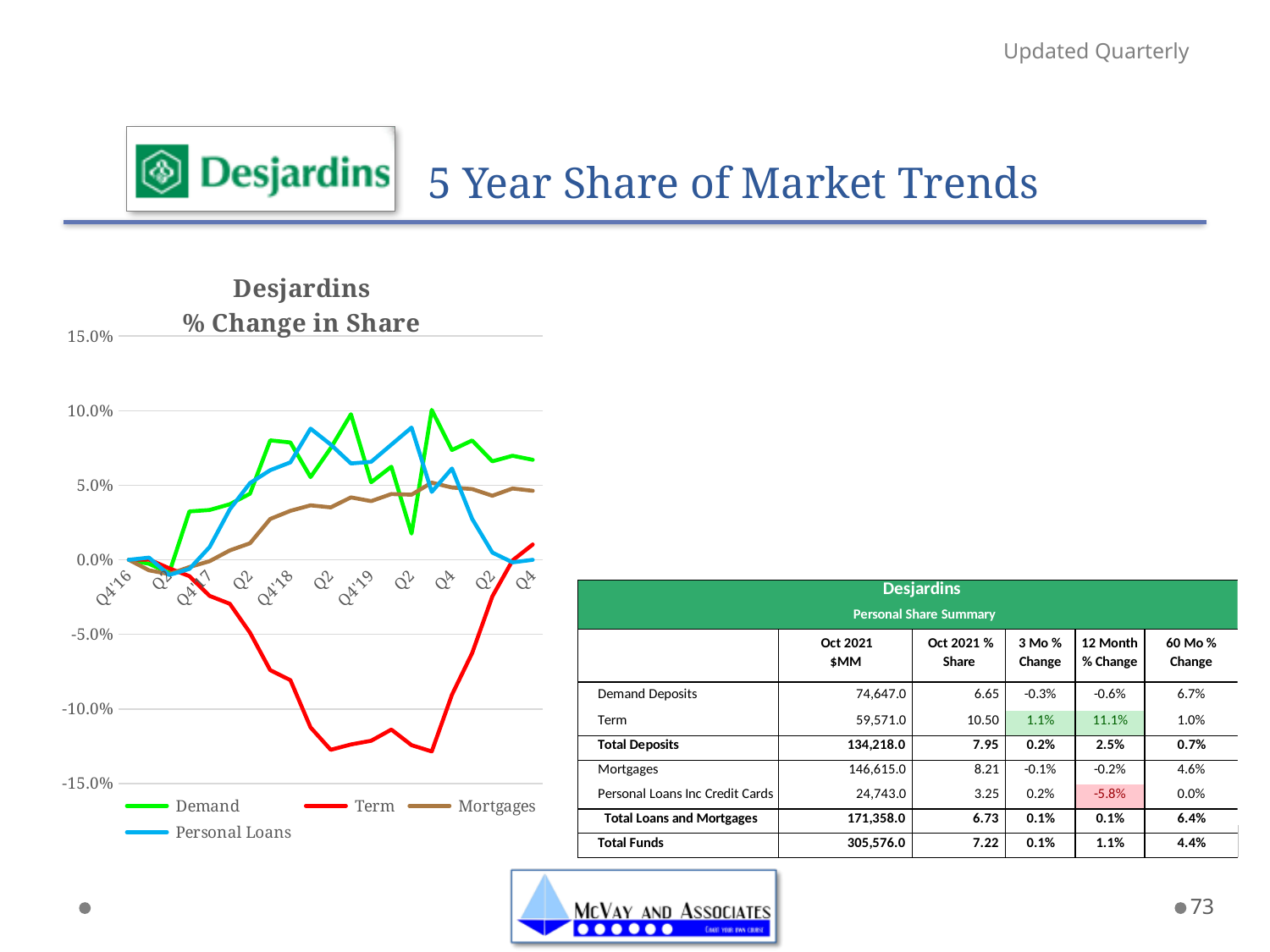
How many labels are shown along the x axis of the chart? 11 Which series has the highest value at the final Q4 on the x axis? Demand How many series does the legend of the chart list? 4 Is the value for Term at Q4'18 greater or less than -5.0%? less Which series reaches the lowest value anywhere on the chart? Term Does the Term series rise or fall from Q4'16 to Q2'18? fall Is the value for Demand at Q4'18 greater or less than 5.0%? greater What kind of chart is shown on the slide? line chart What is the title of the chart? Desjardins % Change in Share At Q4'18, which series has the larger value, Demand or Term? Demand Which series in the chart is drawn in red? Term Is the value for Personal Loans at Q4'18 greater or less than 5.0%? greater